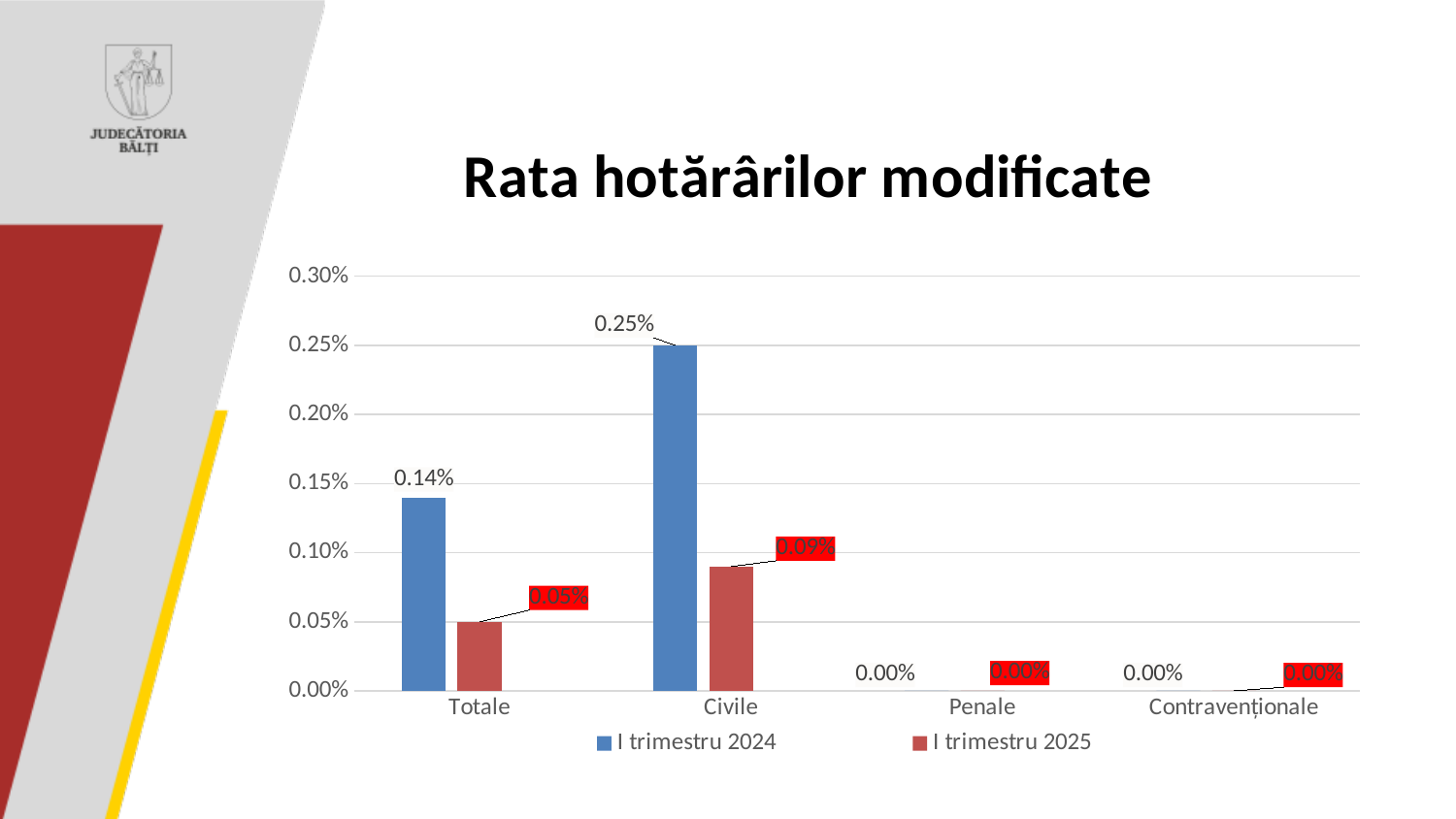
How many series does the legend list? 2 What is the difference between the I trimestru 2024 and I trimestru 2025 values for Civile? 0.16% How many categories are shown on the x axis? 4 What is the value for Civile in the I trimestru 2025 series? 0.09% What type of chart is shown on the slide? Bar chart What is the value for Penale in the I trimestru 2024 series? 0.00% Which is larger for Totale: the I trimestru 2024 value or the I trimestru 2025 value? I trimestru 2024 What is the value for Totale in the I trimestru 2024 series? 0.14% Which category has the highest value in the I trimestru 2024 series? Civile What is the difference between the I trimestru 2024 and I trimestru 2025 values for Totale? 0.09% What is the value for Totale in the I trimestru 2025 series? 0.05% Is the I trimestru 2024 value for Civile greater or less than 0.20%? greater